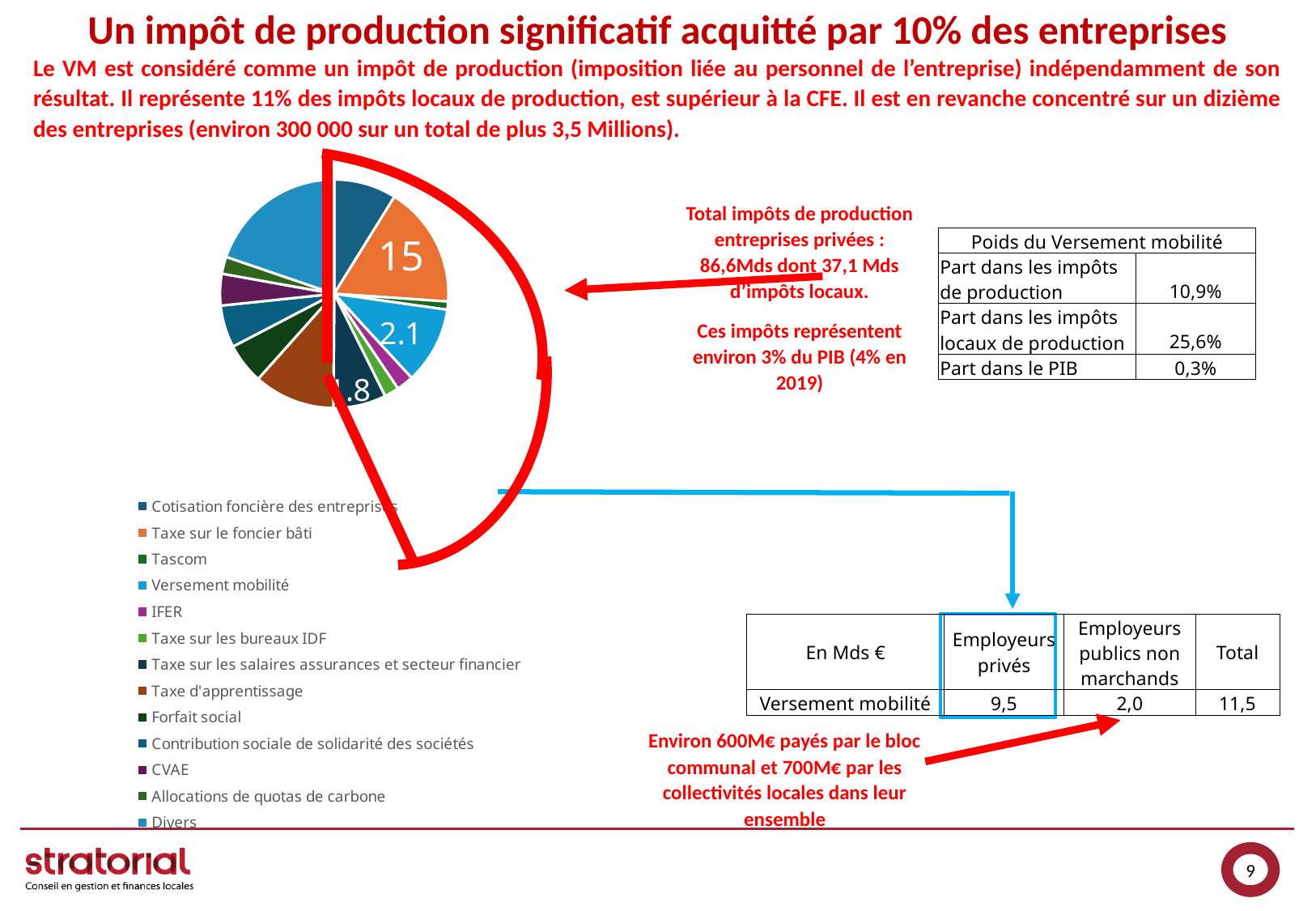
Which legend entry corresponds to the orange slice of the pie chart? Taxe sur le foncier bâti What value is printed on the orange slice (Taxe sur le foncier bâti) of the pie chart? 15 How many data series does the pie chart's legend represent? 1 How many categories does the pie chart's legend list? 13 Which is larger in the pie chart: the slice labelled 15 or the slice labelled 2.1? the slice labelled 15 What kind of chart is shown on the slide? pie chart Is the value printed on the orange slice of the pie chart greater or less than 10? greater What is the first entry listed in the pie chart's legend? Cotisation foncière des entreprises